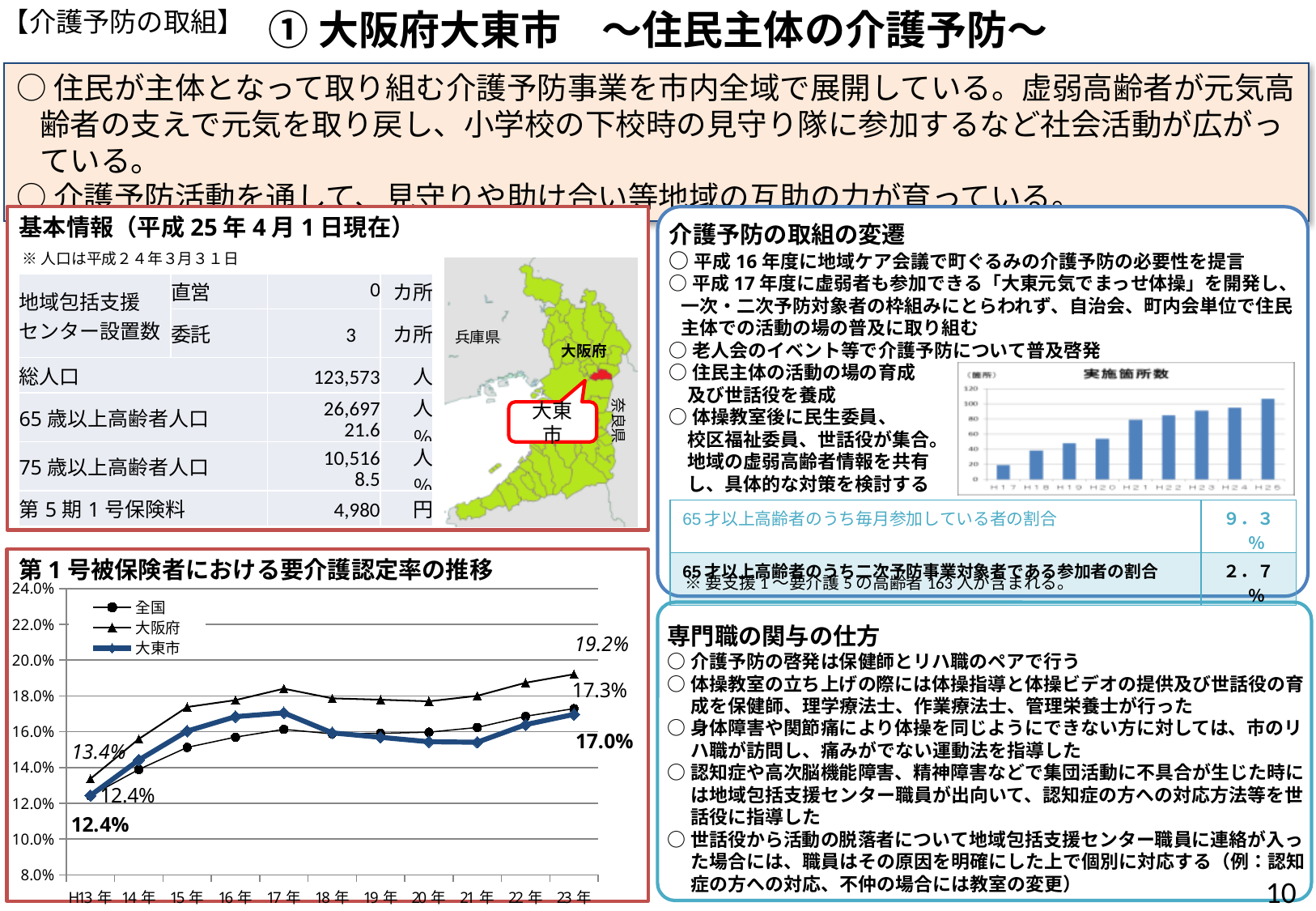
In the 「実施箇所数」 chart, is the value for H17 greater or less than 40? less In the 「実施箇所数」 chart, which year has the highest value? H25 In 「第1号被保険者における要介護認定率の推移」, what is the difference between 大阪府 and 大東市 in 23年? 2.2% What kind of chart is 「第1号被保険者における要介護認定率の推移」? line chart In 「第1号被保険者における要介護認定率の推移」, what is the value for 大東市 in 23年? 17.0% In 「第1号被保険者における要介護認定率の推移」, what is the value for 大阪府 in H13年? 13.4% How many years are plotted along the x axis of 「第1号被保険者における要介護認定率の推移」? 11 How many series does the legend of 「第1号被保険者における要介護認定率の推移」 list? 3 In 「第1号被保険者における要介護認定率の推移」, which series has the highest value in 23年? 大阪府 In 「第1号被保険者における要介護認定率の推移」, what is the value for 大阪府 in 23年? 19.2% How many bars are shown in the 「実施箇所数」 chart? 9 What kind of chart is 「実施箇所数」 on the right side of the slide? bar chart